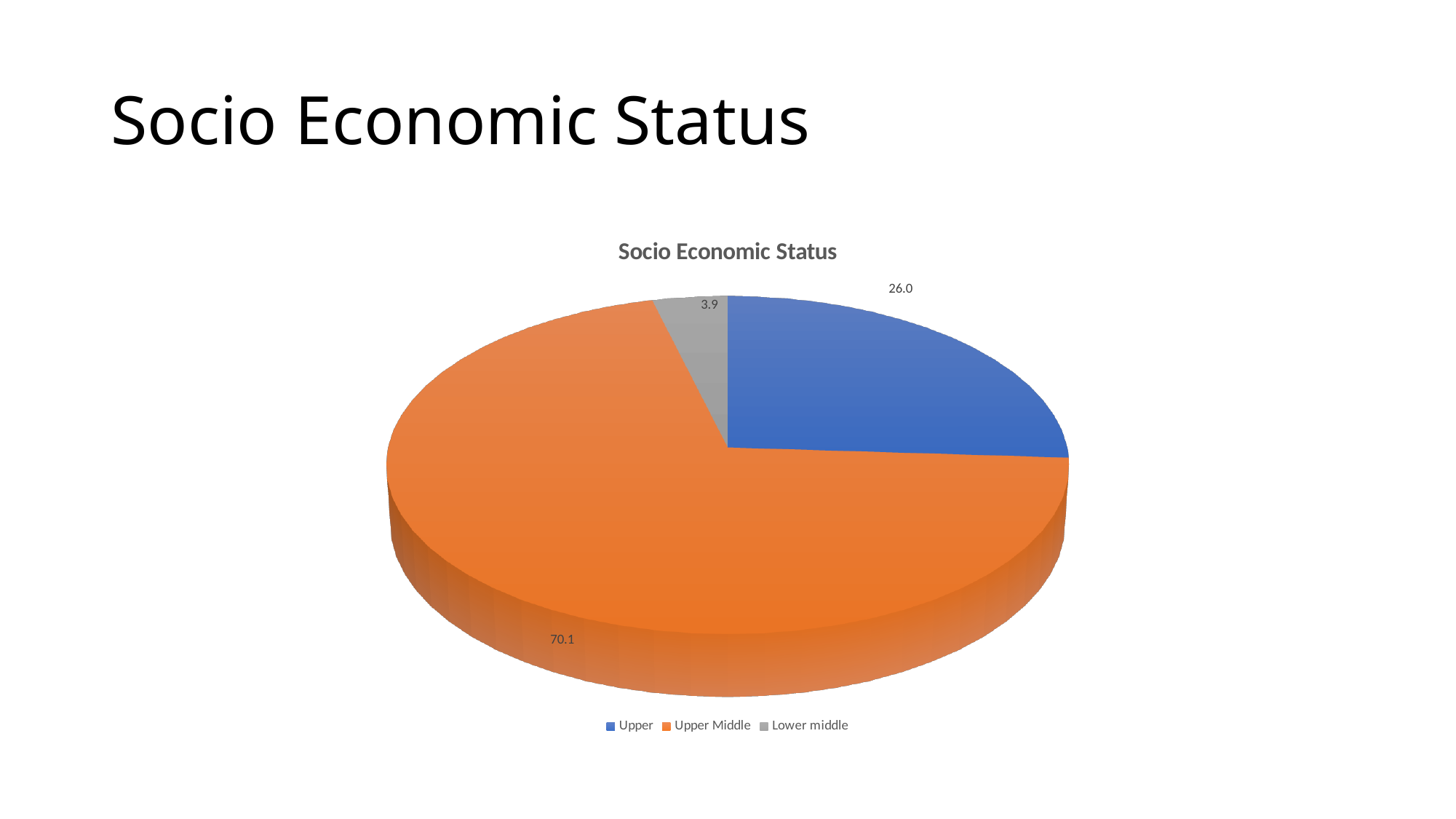
How many categories does the pie chart show? 3 What is the difference between the values for Upper and Lower middle? 22.1 Which is larger, the value for Upper or the value for Lower middle? Upper Which category has the largest slice? Upper Middle Which category has the smallest slice? Lower middle What kind of chart is shown on the slide? Pie chart What is the value for Upper Middle? 70.1 Which colour represents Upper Middle in the chart? Orange What is the value for Upper? 26.0 What is the value for Lower middle? 3.9 What is the title of the chart? Socio Economic Status What is the difference between the values for Upper Middle and Upper? 44.1